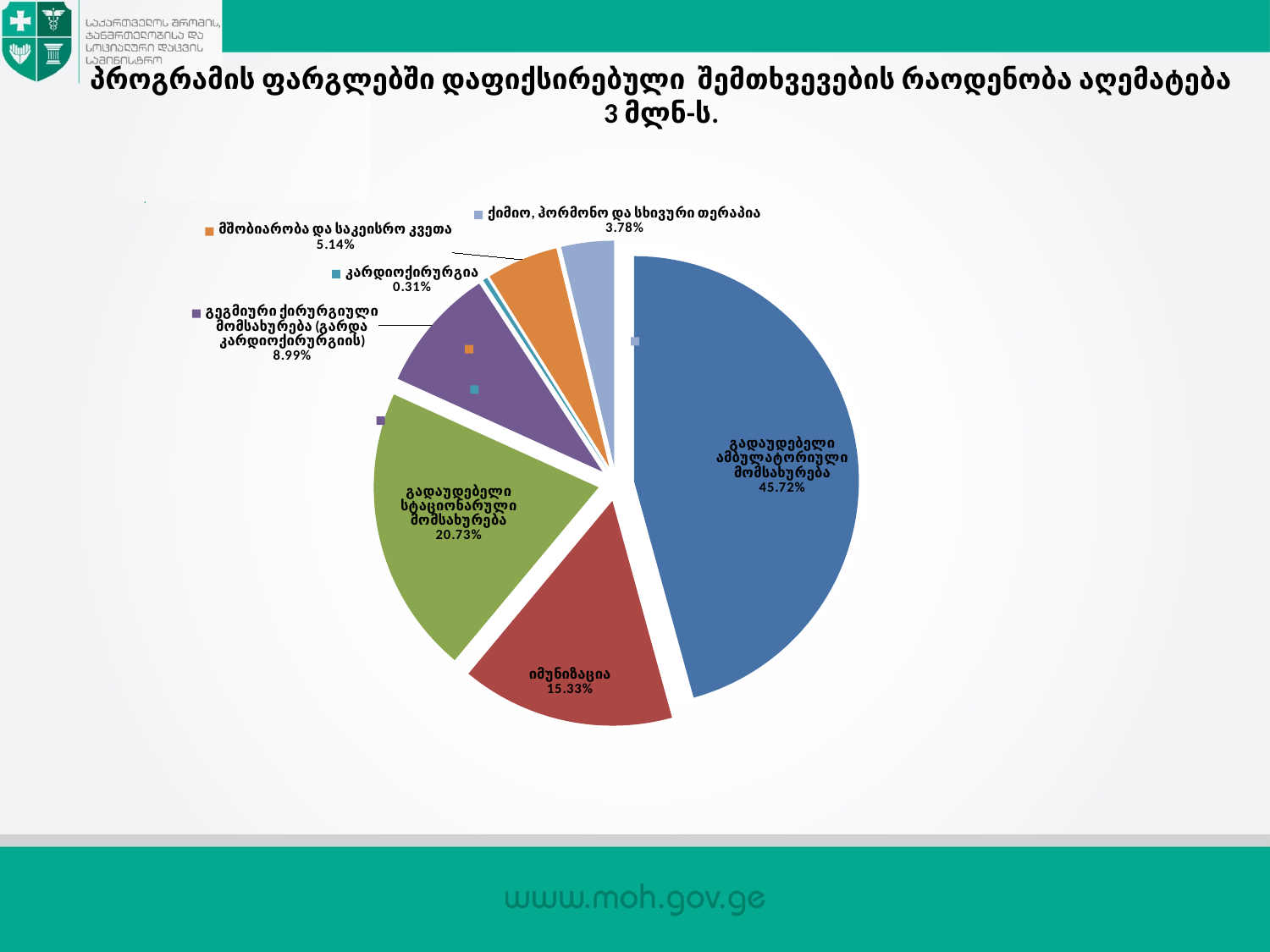
What is the title of the slide containing the pie chart? პროგრამის ფარგლებში დაფიქსირებული შემთხვევების რაოდენობა აღემატება 3 მლნ-ს. Which category has the largest share of the pie? გადაუდებელი ამბულატორიული მომსახურება How many slices does the pie chart have? 7 What percentage is shown for იმუნიზაცია? 15.33% What percentage is shown for გადაუდებელი სტაციონარული მომსახურება? 20.73% Which is larger: the share for იმუნიზაცია or the share for გადაუდებელი სტაციონარული მომსახურება? გადაუდებელი სტაციონარული მომსახურება What kind of chart is shown on the slide? pie chart Which category has the smallest share of the pie? კარდიოქირურგია What share of the pie is გადაუდებელი ამბულატორიული მომსახურება? 45.72% What is the difference in percentage points between გეგმიური ქირურგიული მომსახურება (გარდა კარდიოქირურგიის) and მშობიარობა და საკეისრო კვეთა? 3.85 What percentage is shown for ქიმიო, ჰორმონო და სხივური თერაპია? 3.78% What percentage is shown for კარდიოქირურგია? 0.31%